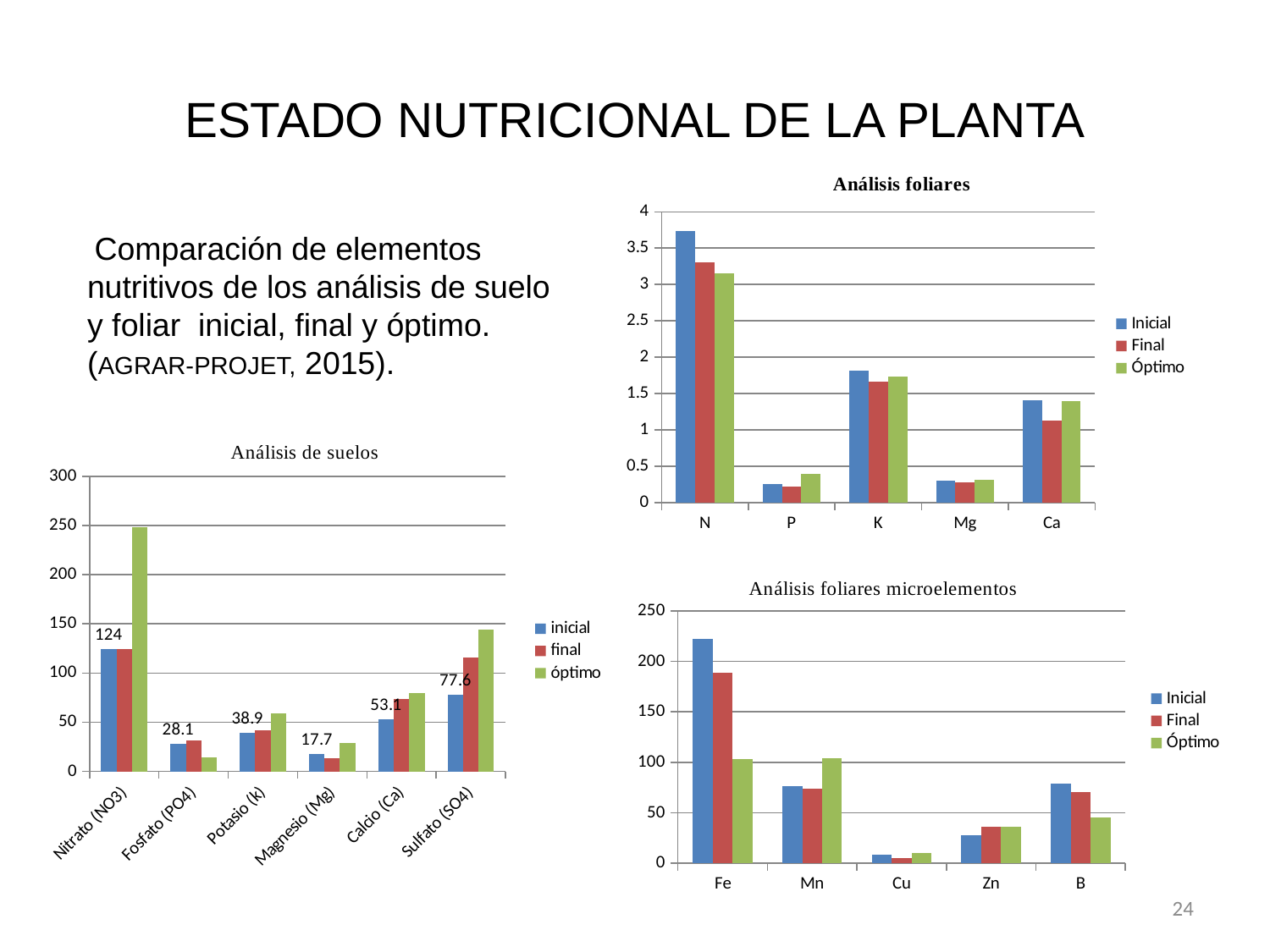
In the 'Análisis de suelos' chart, is the óptimo value for Nitrato (NO3) greater or less than 200? greater In the 'Análisis de suelos' chart, what is the inicial value for Nitrato (NO3)? 124 In the 'Análisis de suelos' chart, what is the inicial value for Magnesio (Mg)? 17.7 How many series does the legend of the 'Análisis foliares microelementos' chart list? 3 In the 'Análisis foliares microelementos' chart, is the Inicial value for Fe greater or less than 200? greater In the 'Análisis de suelos' chart, which category has the highest inicial value? Nitrato (NO3) In the 'Análisis foliares microelementos' chart, which element has the lowest Inicial value? Cu In the 'Análisis de suelos' chart, what is the inicial value for Sulfato (SO4)? 77.6 In the 'Análisis foliares' chart, is the Inicial value for N greater or less than 3.5? greater How many categories are shown on the x axis of the 'Análisis de suelos' chart? 6 In the 'Análisis de suelos' chart, what is the difference between the inicial values for Calcio (Ca) and Fosfato (PO4)? 25 In the 'Análisis foliares' chart, which element has the highest Inicial value? N